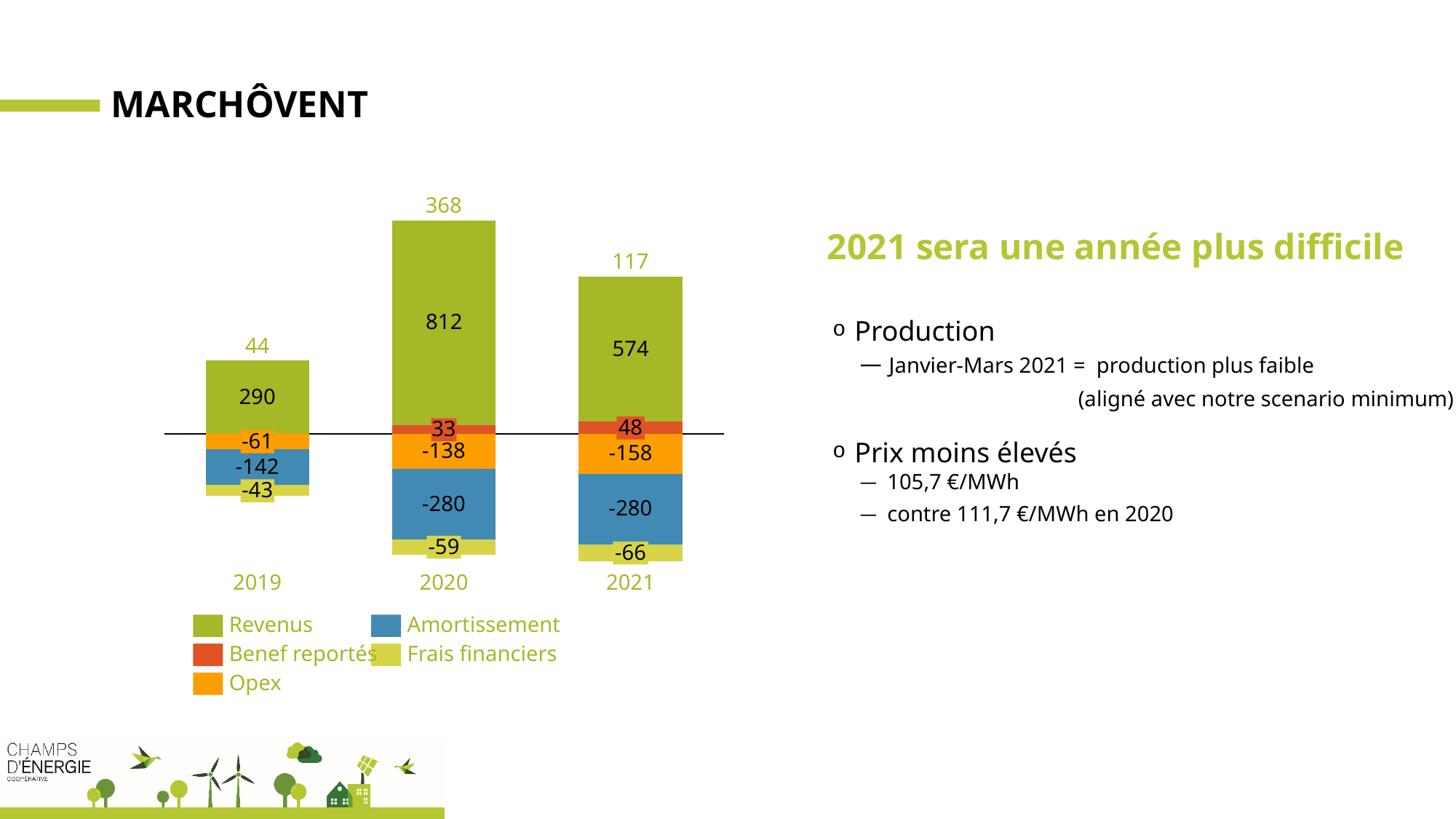
What is the Benef reportés value for 2021? 48 How many years are shown on the x axis of the chart? 3 What is the Frais financiers value for 2020? -59 What is the Amortissement value for 2019? -142 Which year has the lowest total shown above its bar? 2019 Is the Revenus value for 2019 larger or smaller than the Revenus value for 2021? smaller What is the Opex value for 2021? -158 How many series does the legend list? 5 What is the total shown above the bar for 2020? 368 What is the difference between the Revenus values for 2020 and 2021? 238 What is the Revenus value for 2020? 812 Which year has the highest Revenus value? 2020